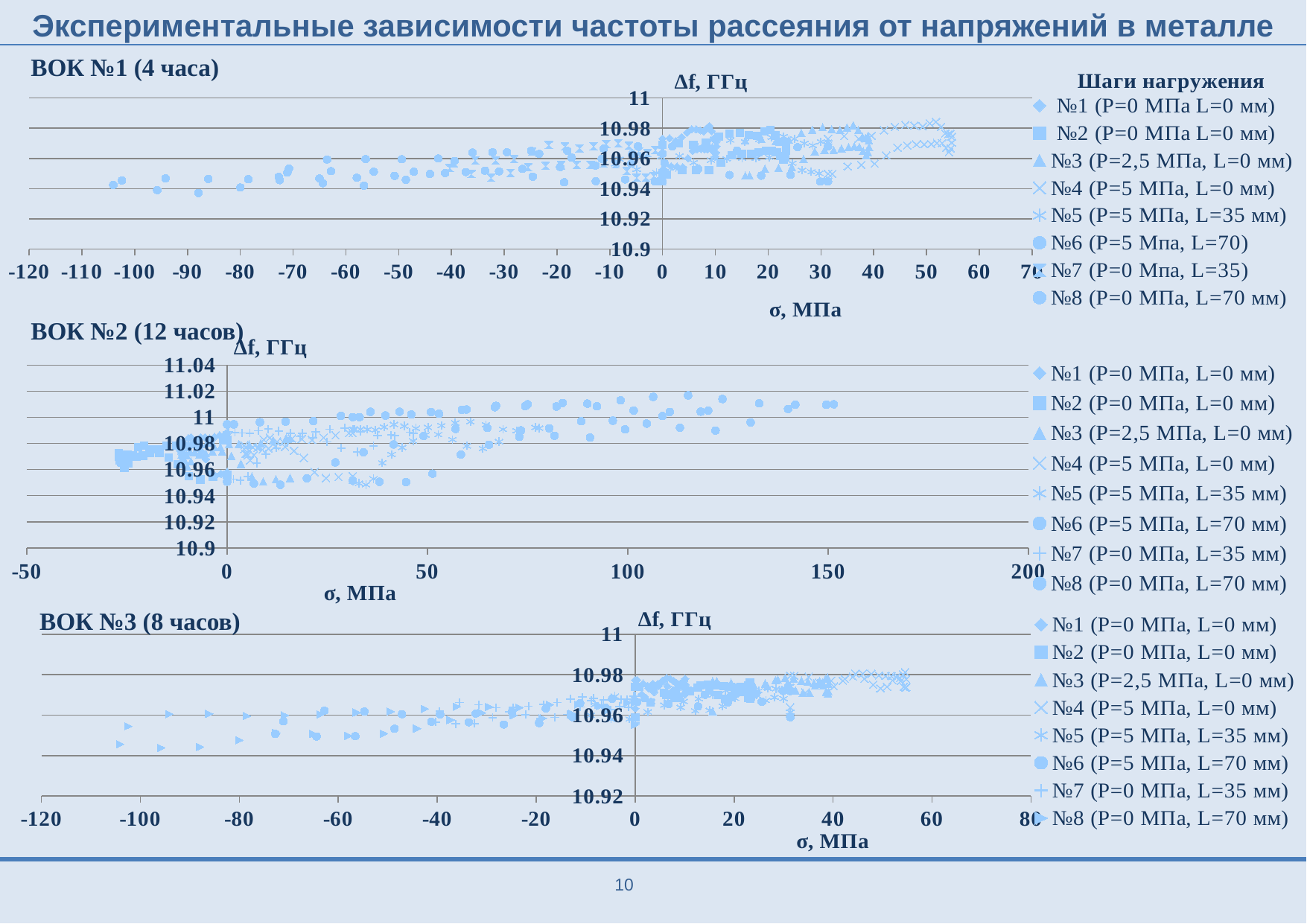
In the ВОК №3 (8 часов) chart, do the Δf values generally rise or fall as σ increases? rise How many series does the legend of the ВОК №3 (8 часов) chart list? 8 What is the title of the y axis on the ВОК №2 (12 часов) chart? Δf, ГГц In the ВОК №1 (4 часа) chart, are the Δf values at σ = -100 МПа greater or less than 10.96? less What is the legend title shown on the ВОК №1 (4 часа) chart? Шаги нагружения In the ВОК №1 (4 часа) chart, do the Δf values generally rise or fall as σ increases along the x axis? rise In the ВОК №2 (12 часов) chart, are the Δf values at σ = 150 МПа greater or less than 10.98? greater How many charts are shown on the slide? 3 What kind of chart is the ВОК №1 (4 часа) chart? scatter chart How many series does the legend of the ВОК №2 (12 часов) chart list? 8 In the ВОК №2 (12 часов) chart, do the Δf values generally rise or fall as σ increases? rise What is the maximum value shown on the y axis of the ВОК №2 (12 часов) chart? 11.04